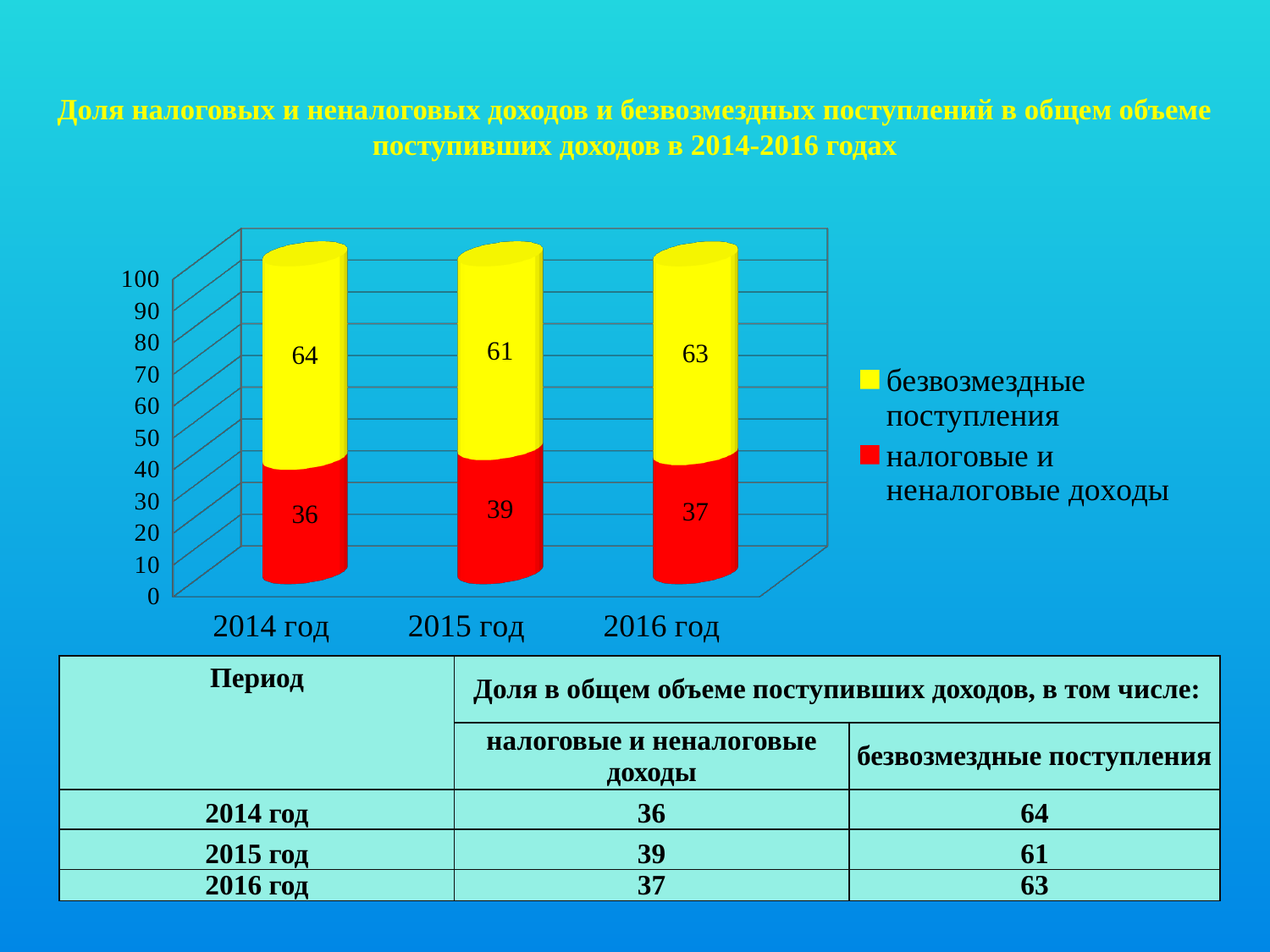
In which year is the value for безвозмездные поступления lowest? 2015 год What kind of chart is shown on the slide? stacked bar chart How many series does the legend list? 2 How many years are shown on the x axis? 3 What is the value for налоговые и неналоговые доходы in 2014 год? 36 What is the value for безвозмездные поступления in 2015 год? 61 What is the total of the stacked bar for 2015 год? 100 What is the difference between безвозмездные поступления and налоговые и неналоговые доходы in 2014 год? 28 Which colour represents безвозмездные поступления in the chart? yellow What is the value for безвозмездные поступления in 2016 год? 63 Which is larger in 2016 год: безвозмездные поступления or налоговые и неналоговые доходы? безвозмездные поступления In which year is the value for налоговые и неналоговые доходы highest? 2015 год